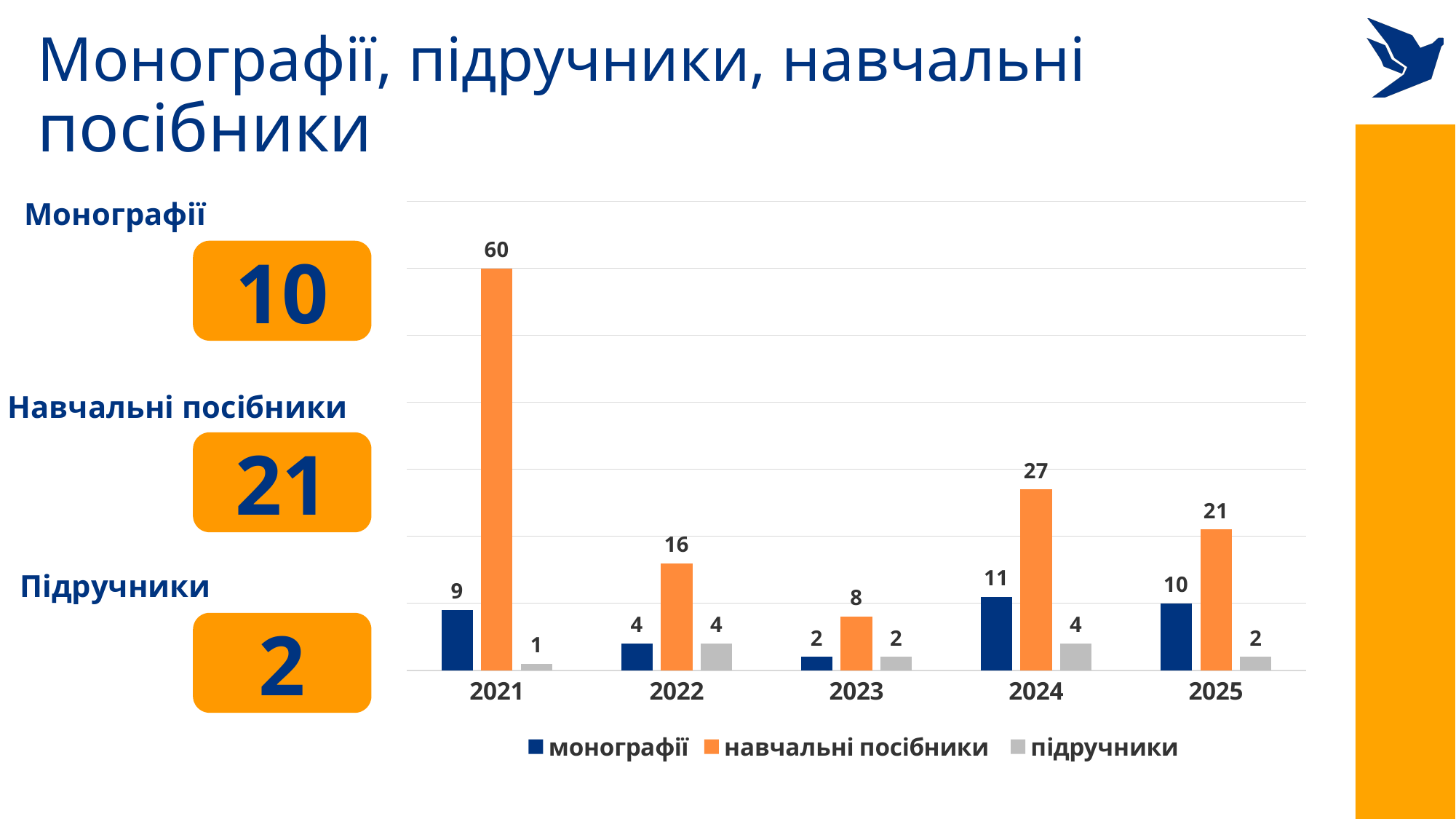
How many series does the legend list? 3 What is the difference between навчальні посібники in 2024 and in 2025? 6 Does the value for монографії rise or fall from 2023 to 2024? rise What is the value for підручники in 2022? 4 What is the value for навчальні посібники in 2021? 60 In which year is the value for навчальні посібники the highest? 2021 Which colour represents підручники in the chart? grey In which year is the value for монографії the lowest? 2023 Which is larger: монографії in 2022 or монографії in 2025? монографії in 2025 What kind of chart is shown on the slide? bar chart What is the value for монографії in 2024? 11 How many years are shown on the x axis? 5